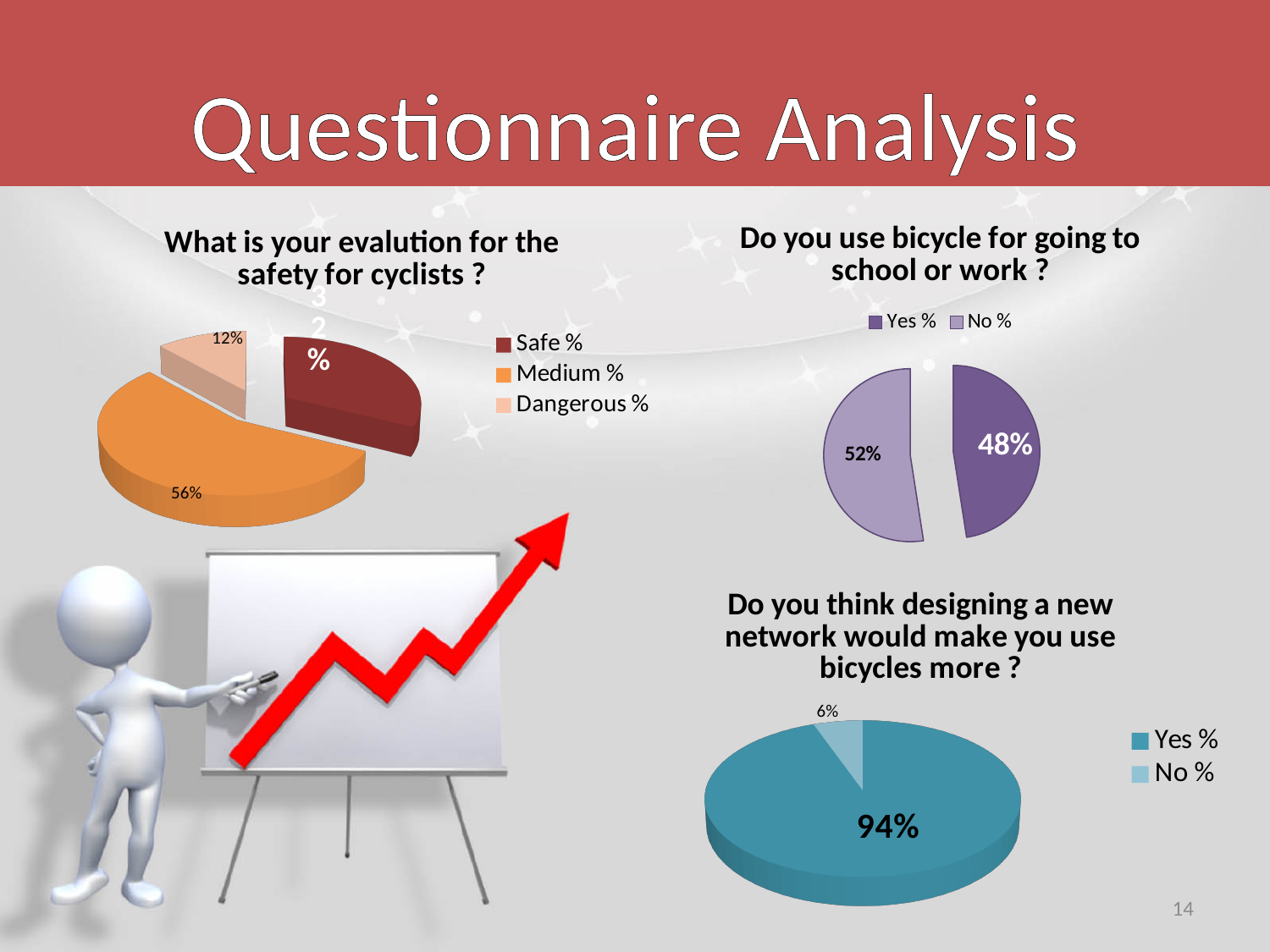
What type of chart is used for 'Do you think designing a new network would make you use bicycles more ?'? Pie chart In the chart 'Do you use bicycle for going to school or work ?', what percentage answered No %? 52% In the chart 'Do you use bicycle for going to school or work ?', what percentage answered Yes %? 48% In the chart 'What is your evalution for the safety for cyclists ?', how many categories does the legend list? 3 In the chart 'What is your evalution for the safety for cyclists ?', which category has the largest share? Medium % In the chart 'Do you think designing a new network would make you use bicycles more ?', what percentage answered Yes %? 94% In the chart 'Do you use bicycle for going to school or work ?', what is the difference between No % and Yes %? 4% In the chart 'Do you think designing a new network would make you use bicycles more ?', what percentage answered No %? 6% In the chart 'What is your evalution for the safety for cyclists ?', what percentage is shown for Medium %? 56% In the chart 'What is your evalution for the safety for cyclists ?', which category has the smallest share? Dangerous % In the chart 'Do you use bicycle for going to school or work ?', which is larger, Yes % or No %? No % In the chart 'What is your evalution for the safety for cyclists ?', what percentage is shown for Dangerous %? 12%